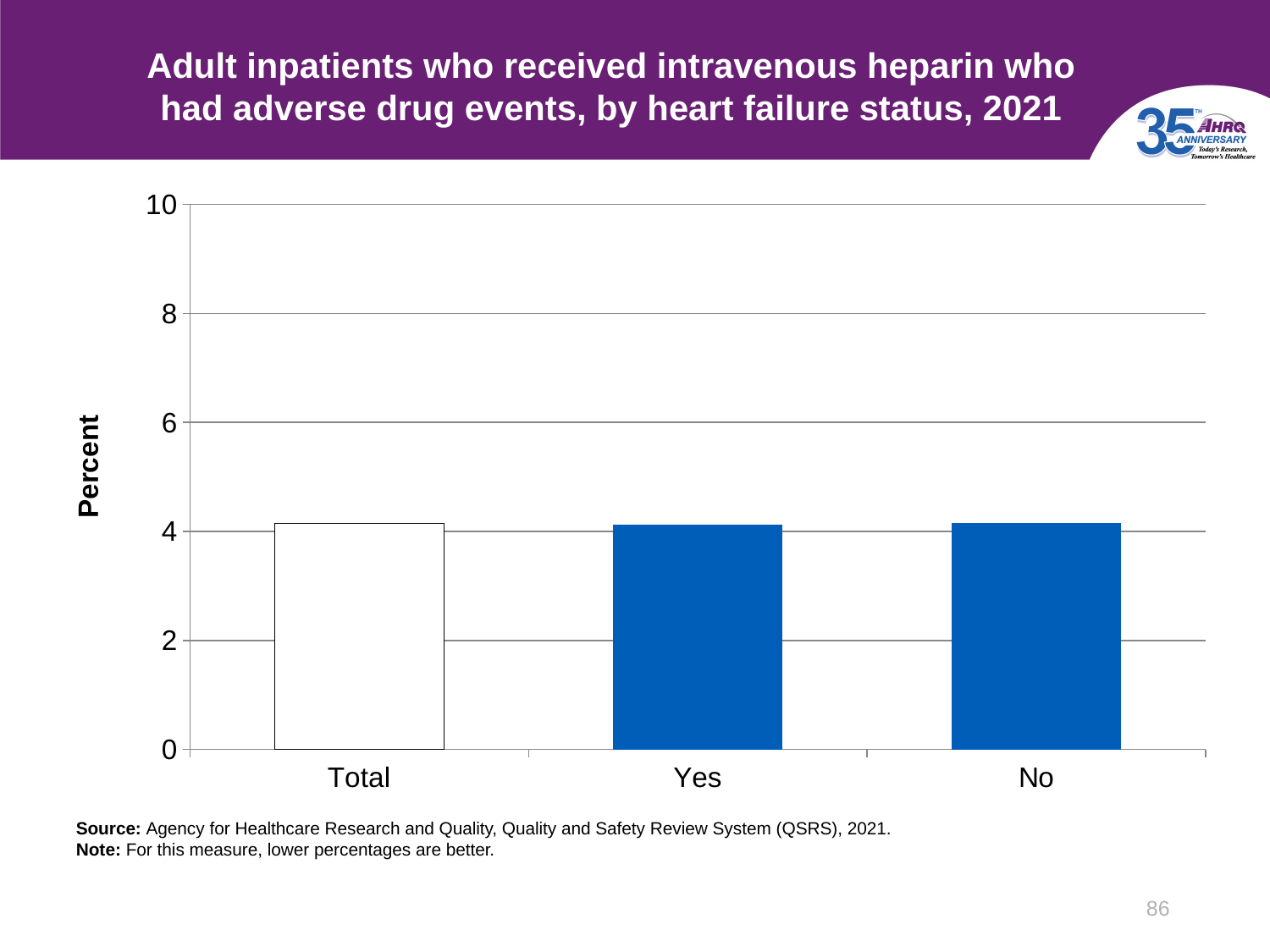
How many categories are shown on the x axis of the chart? 3 Is the value for Total greater or less than 2? greater What kind of chart is shown on the slide? bar chart What is the title of the chart? Adult inpatients who received intravenous heparin who had adverse drug events, by heart failure status, 2021 Is the value for Total greater or less than 6? less Is the value for No greater or less than 6? less What is the label on the y axis of the chart? Percent What is the highest value shown on the y axis of the chart? 10